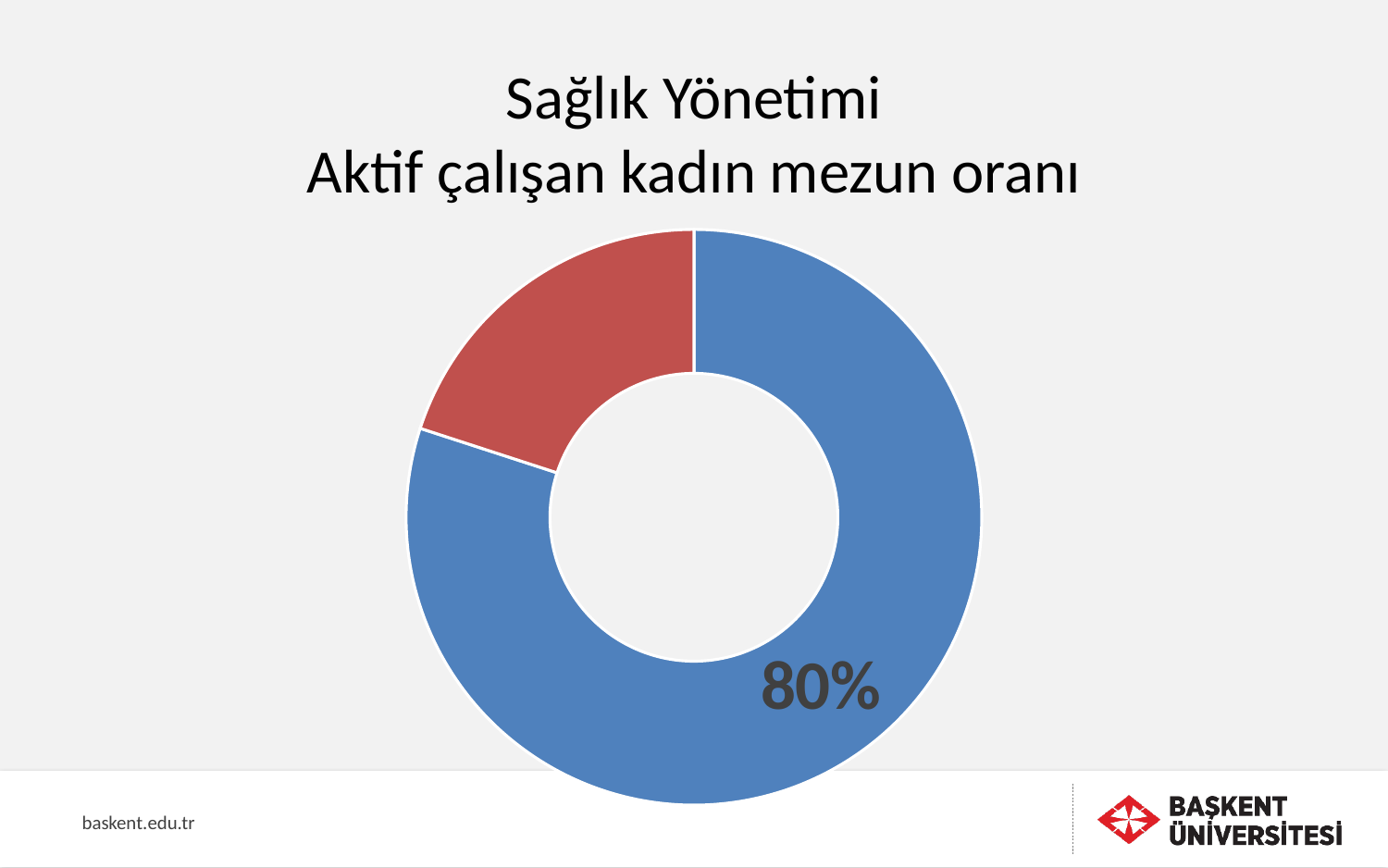
Which slice is larger, the blue one or the red one? The blue one What share of the doughnut does the blue slice represent? 80% Which slice of the chart is the smallest? The red slice What is the title of the chart? Sağlık Yönetimi Aktif çalışan kadın mezun oranı Which slice of the chart is the largest? The blue slice (80%) What colour is the slice labelled 80%? Blue What percentage is printed on the blue slice of the chart? 80% How many slices does the doughnut chart have? 2 What kind of chart is shown on the slide? Doughnut (pie) chart